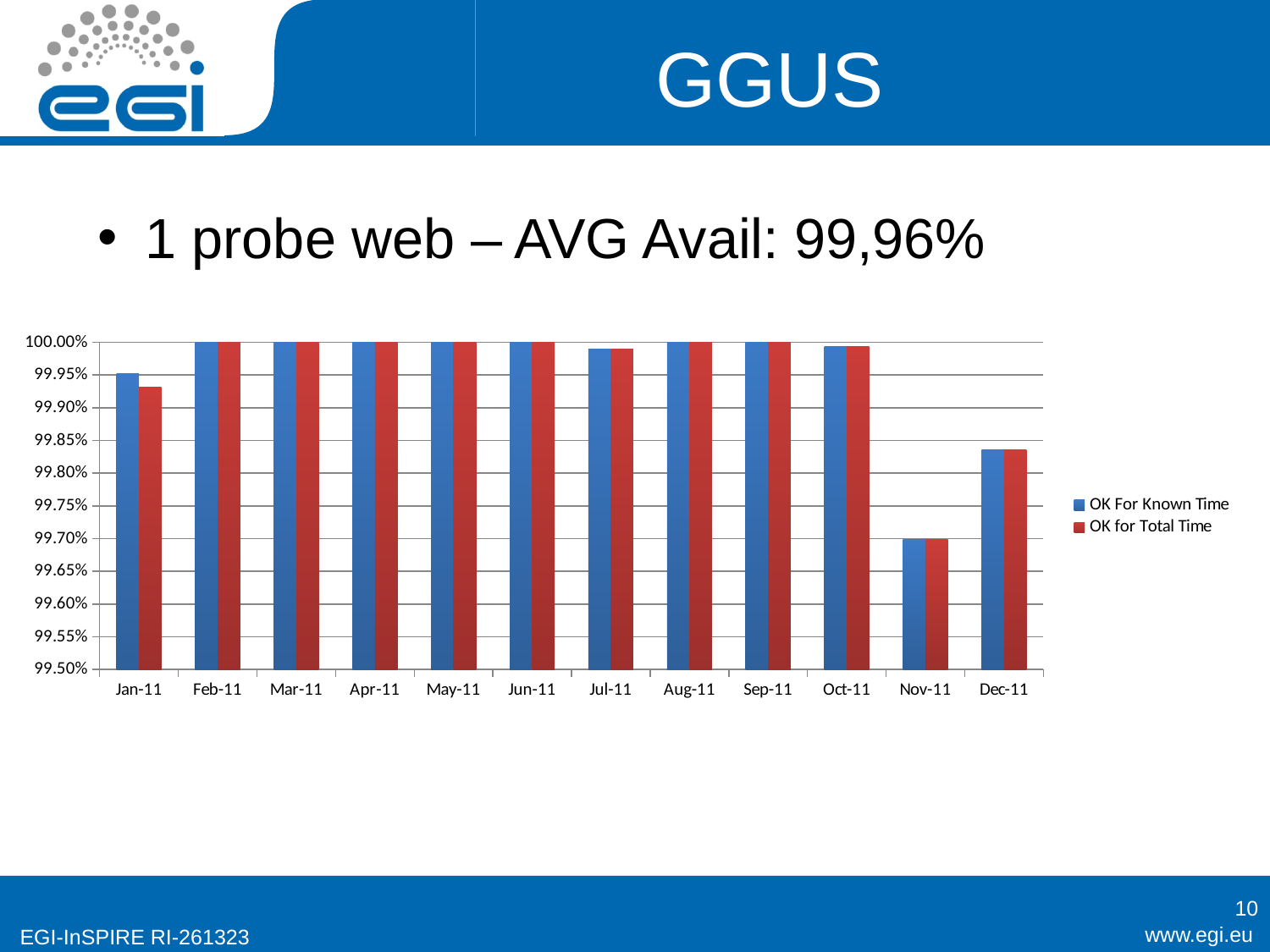
Which is larger, the OK For Known Time value for Jan-11 or for Nov-11? Jan-11 What kind of chart is shown on the slide? bar chart What is the value for OK For Known Time in Feb-11? 100.00% How many series does the legend list? 2 Which is larger, the OK for Total Time value for Dec-11 or for Nov-11? Dec-11 Is the value for OK For Known Time in Dec-11 greater or less than 99.80%? greater How many months are shown on the x axis of the chart? 12 Is the value for OK for Total Time in Jan-11 greater or less than 99.90%? greater What colour are the bars for the OK for Total Time series? red Is the value for OK for Total Time in Nov-11 greater or less than 99.75%? less Which month has the lowest value for OK For Known Time? Nov-11